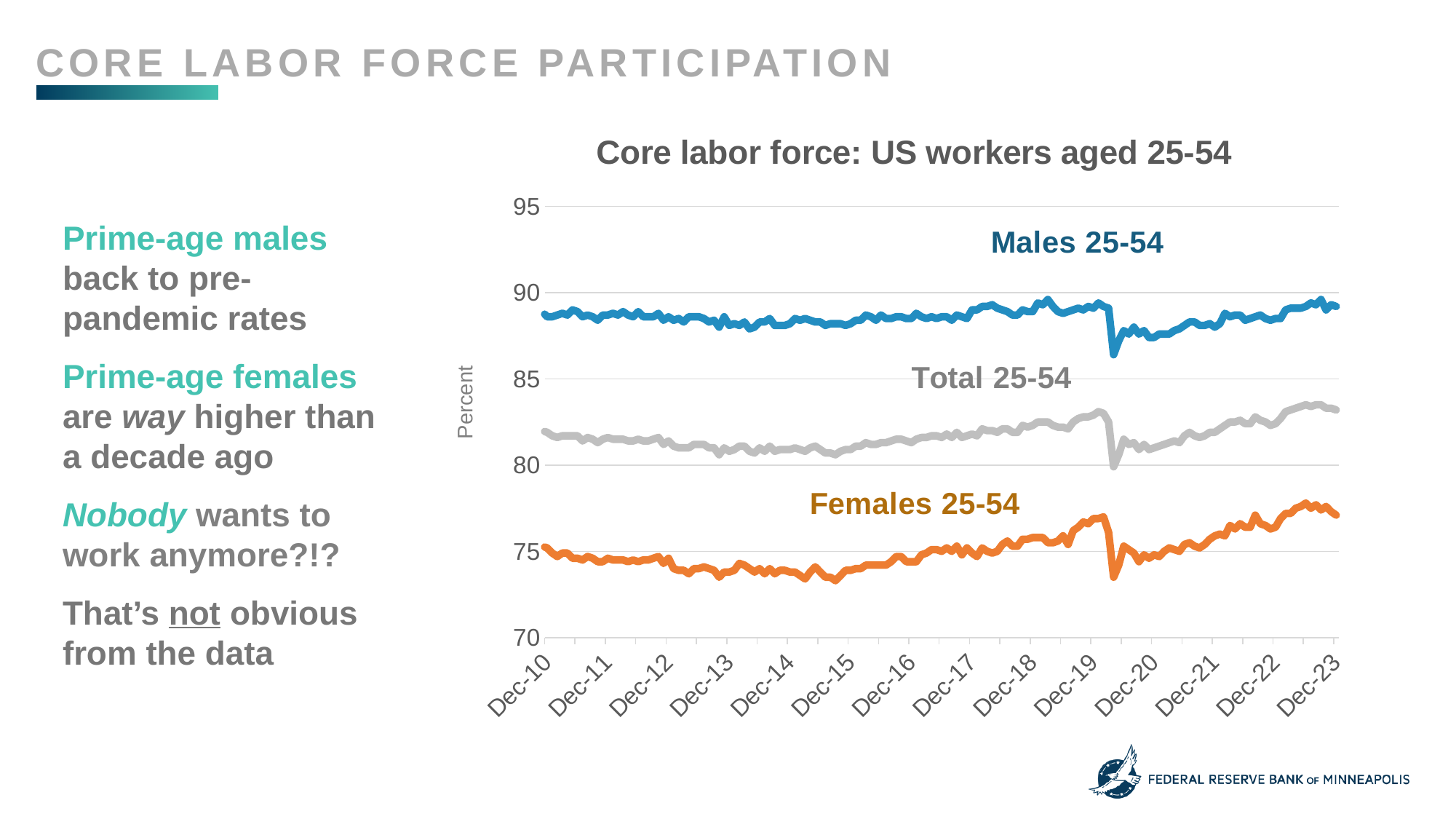
Is the value for Females 25-54 at Dec-15 greater or less than 75? less Is the value for Total 25-54 at Dec-23 greater or less than 80? greater What is the title of the chart? Core labor force: US workers aged 25-54 Does the Females 25-54 series rise or fall overall from Dec-15 to Dec-23? Rise Is the value for Males 25-54 at Dec-10 greater or less than 90? less What kind of chart is shown on the slide? Line chart Which series has the lowest values throughout the chart? Females 25-54 What is the label on the vertical axis of the chart? Percent How many series are plotted on the chart? 3 Which series has the highest values throughout the chart? Males 25-54 Which is larger at Dec-23, the value for Males 25-54 or the value for Females 25-54? Males 25-54